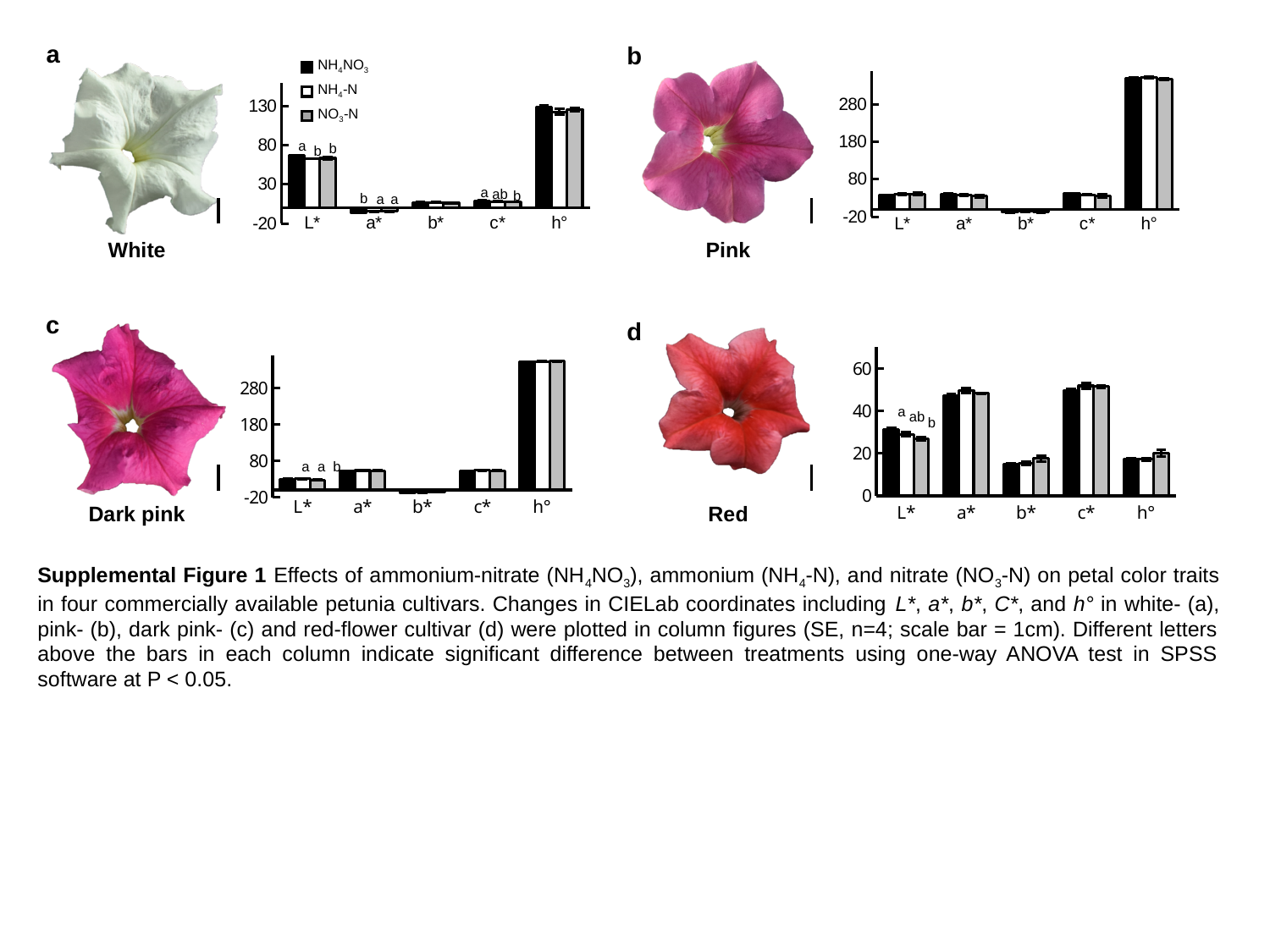
In the Red (panel d) chart, which is larger, the NH4NO3 value for a* or the NH4NO3 value for b*? a* In the White (panel a) chart, is the NH4NO3 value for L* greater or less than 30? greater In the Pink (panel b) chart, is the NH4NO3 value for h° greater or less than 280? greater How many series does the legend in panel a list? 3 Which series is shown with black bars in the legend of panel a? NH4NO3 In the White (panel a) chart, which category has the highest bars? h° In the Red (panel d) chart, is the NH4NO3 value for b* greater or less than 20? less How many categories are shown on the x axis of the Red (panel d) chart? 5 In the Dark pink (panel c) chart, which category has the highest bars? h° In the White (panel a) chart, which is larger, the value for L* or the value for c* under NH4NO3? L* In the Pink (panel b) chart, which category has the lowest bars? b* What kind of chart is used in panel a (White)? bar chart